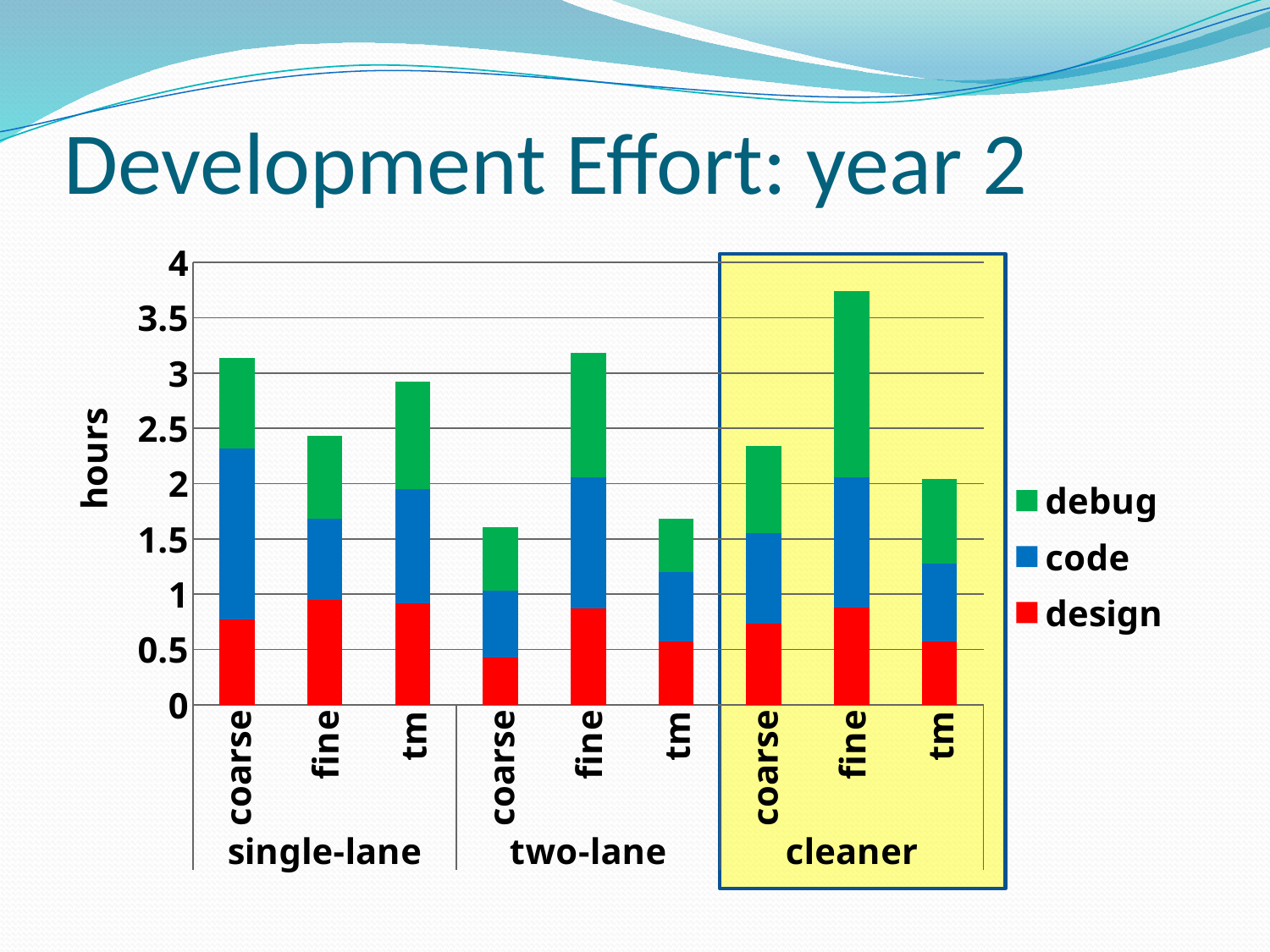
How many bars are plotted in the chart? 9 What kind of chart is shown on the slide? stacked bar chart Which group of bars is highlighted with a yellow box? cleaner Is the total for the single-lane coarse bar greater or less than 3 hours? greater Is the total for the cleaner fine bar greater or less than 3.5 hours? greater Which has a larger total: two-lane fine or two-lane tm? two-lane fine Which bar has the highest total hours? cleaner fine What is the label on the vertical axis? hours Which has a larger total: single-lane coarse or single-lane fine? single-lane coarse Is the total for the cleaner coarse bar greater or less than 2.5 hours? less How many series does the legend list? 3